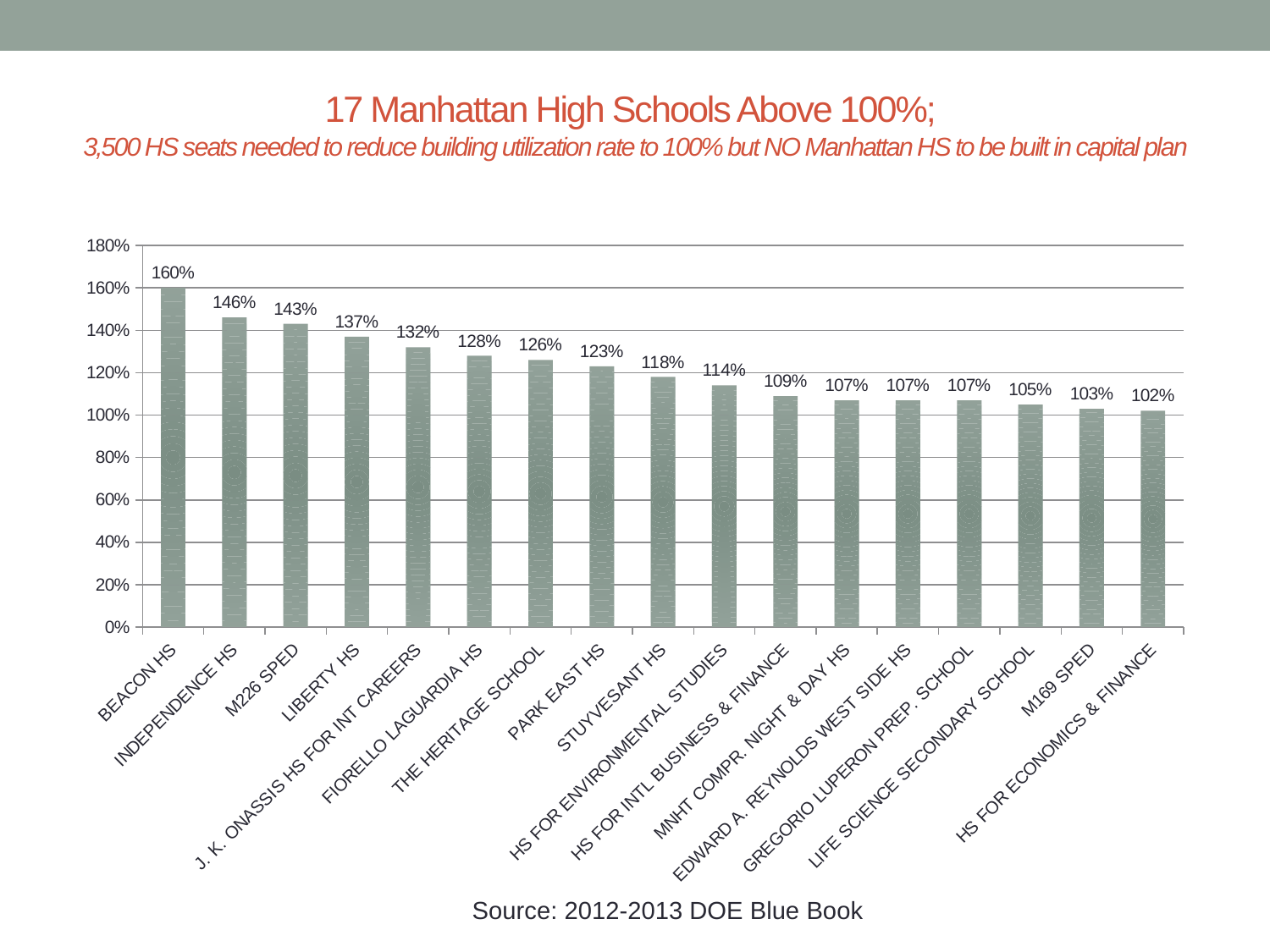
How many schools are shown on the chart? 17 Which school has the lowest utilization rate on the chart? HS FOR ECONOMICS & FINANCE What is the value shown for STUYVESANT HS? 118% What is the difference between the values for LIBERTY HS and PARK EAST HS? 14% What kind of chart is shown on the slide? Bar chart What is the utilization rate shown for BEACON HS? 160% What is the value shown for M169 SPED? 103% Which has a higher value, M226 SPED or THE HERITAGE SCHOOL? M226 SPED Which school has the highest utilization rate on the chart? BEACON HS What is the difference between the values for BEACON HS and INDEPENDENCE HS? 14% Do the values rise or fall moving from left to right along the x axis? Fall What is the value shown for FIORELLO LAGUARDIA HS? 128%